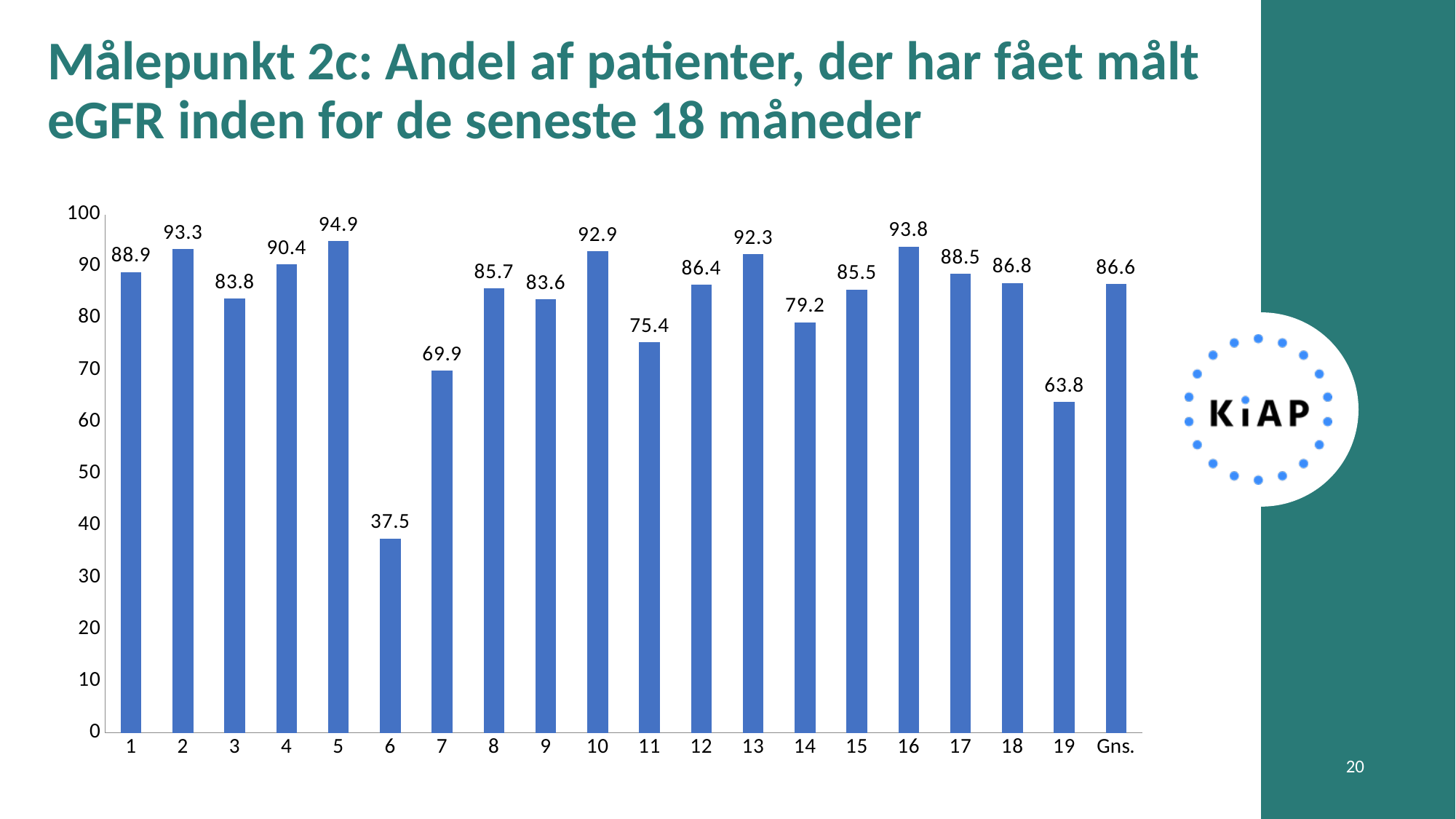
What is the difference between the values for category 5 and category 6? 57.4 What is the value for category 6? 37.5 Which is larger, the value for category 11 or the value for category 14? 14 What kind of chart is shown on the slide? bar chart What is the value for Gns.? 86.6 How many bars are shown in the chart? 20 What is the difference between the value for category 1 and Gns.? 2.3 What is the value for category 16? 93.8 Is the value for category 19 greater or less than 70? less Which category has the highest value? 5 Which category has the lowest value? 6 What is the label of the last category on the x axis? Gns.